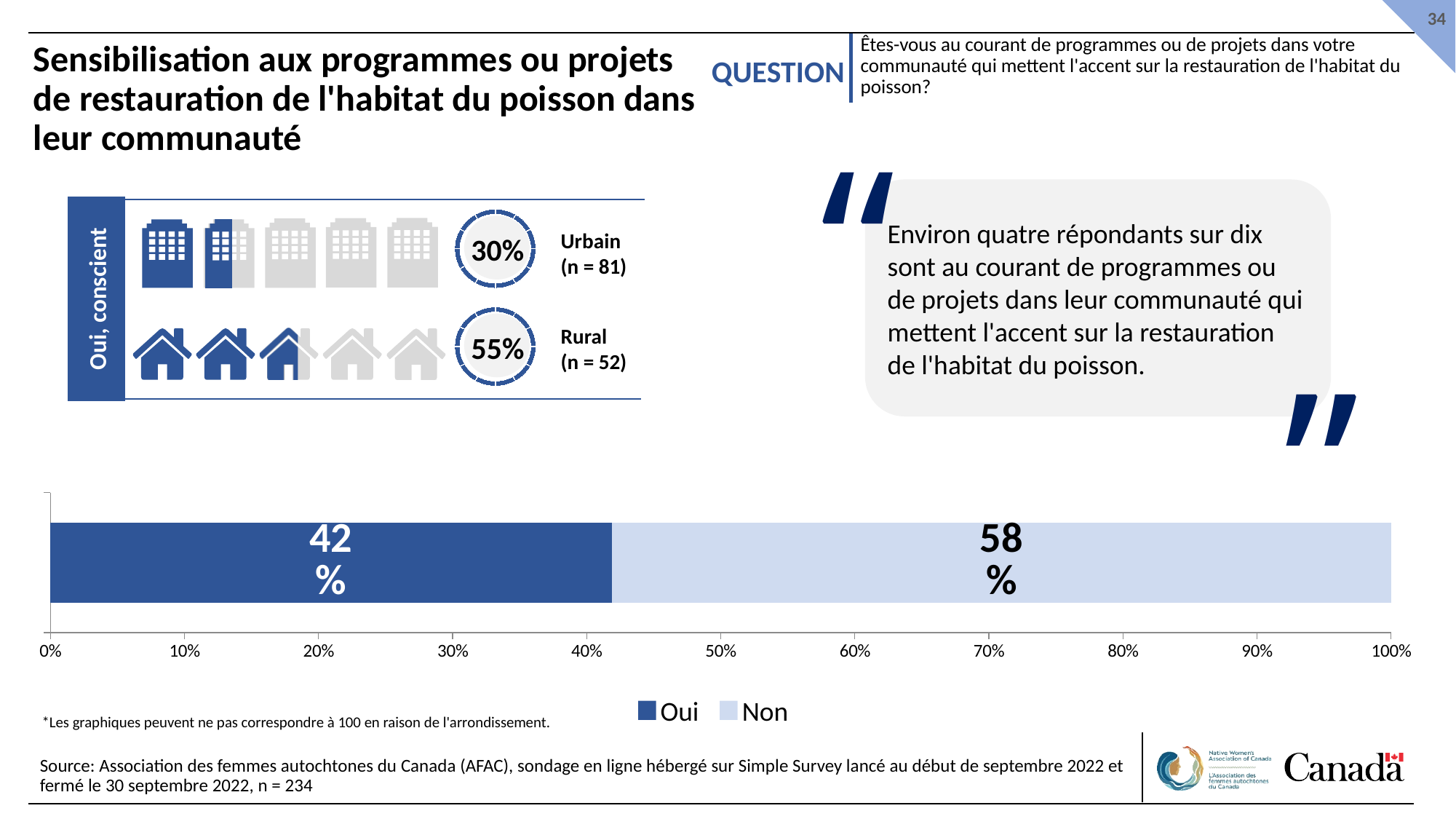
What kind of chart is shown at the bottom of the slide? Stacked bar chart In the infographic on the upper left of the slide, which group has the higher share of Oui, conscient, Urbain or Rural? Rural In the stacked bar chart at the bottom of the slide, which legend entry is shown in dark blue? Oui In the stacked bar chart at the bottom of the slide, what is the value for Non? 58% In the infographic on the upper left of the slide, what percentage of Urbain respondents answered Oui, conscient? 30% In the stacked bar chart at the bottom of the slide, what is the total of the Oui and Non segments? 100% In the stacked bar chart at the bottom of the slide, what is the difference between the Non and Oui values? 16% In the infographic on the upper left of the slide, what percentage of Rural respondents answered Oui, conscient? 55% In the stacked bar chart at the bottom of the slide, which segment is larger, Oui or Non? Non In the stacked bar chart at the bottom of the slide, what is the value for Oui? 42% In the stacked bar chart at the bottom of the slide, is the value for Oui greater or less than 50%? less How many series does the legend of the stacked bar chart at the bottom of the slide list? 2